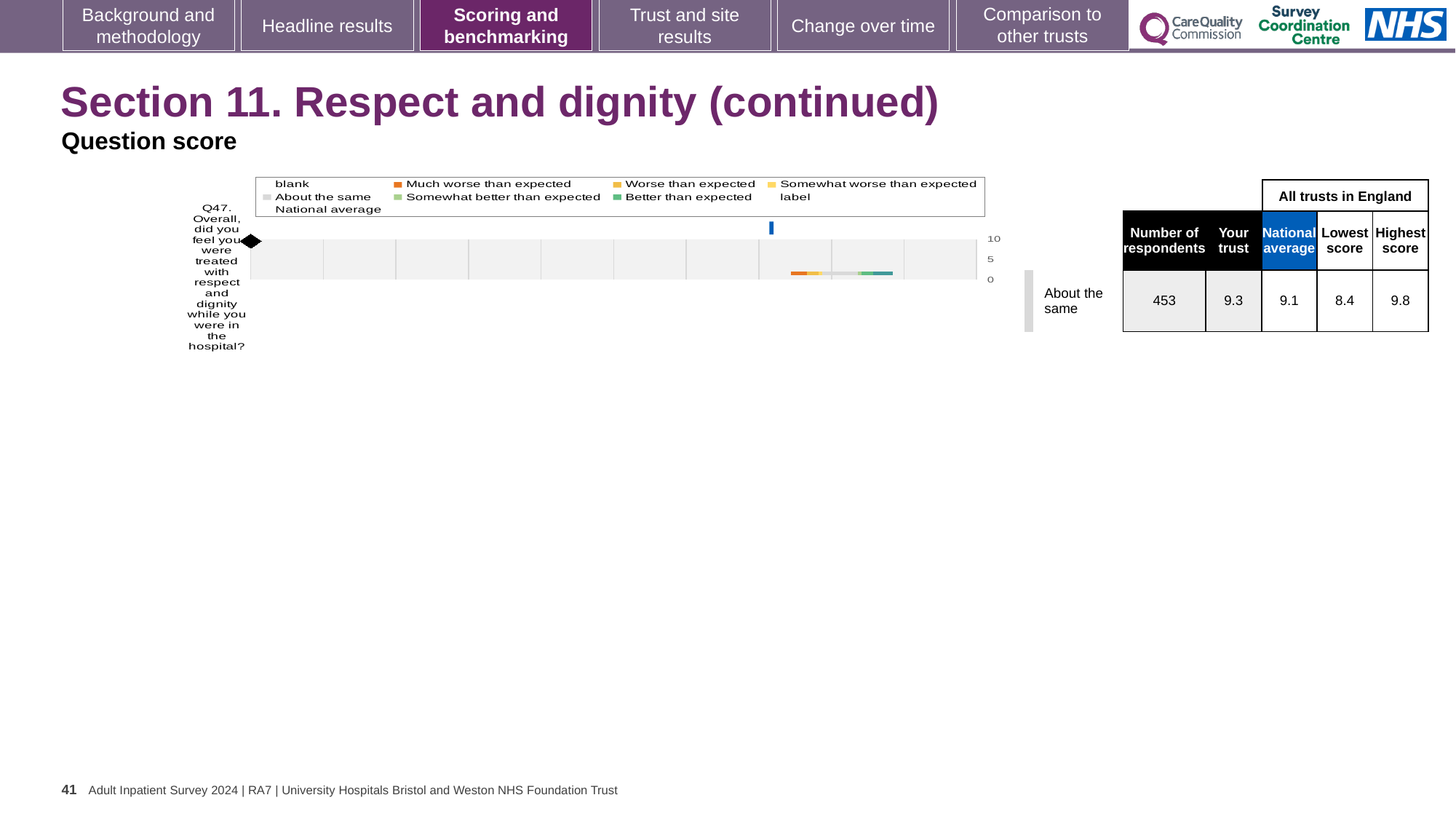
Which question number is plotted on the chart? Q47 What kind of chart is shown on the slide? bar chart For Q47, what is the difference between the Highest score and the Lowest score among all trusts in England? 1.4 In the table beside the chart, what is the Lowest score among all trusts in England for Q47? 8.4 For Q47, which is larger: the 'Your trust' score or the National average? Your trust In the table beside the chart, what is the Highest score among all trusts in England for Q47? 9.8 How many entries does the chart legend list? 9 In the table beside the chart, what is the National average score for Q47? 9.1 In the table beside the chart, what is the 'Your trust' score for Q47? 9.3 How many questions are plotted on the chart? 1 What is the highest tick value shown on the chart's score axis? 10 In the table beside the chart, how many respondents are recorded for Q47? 453